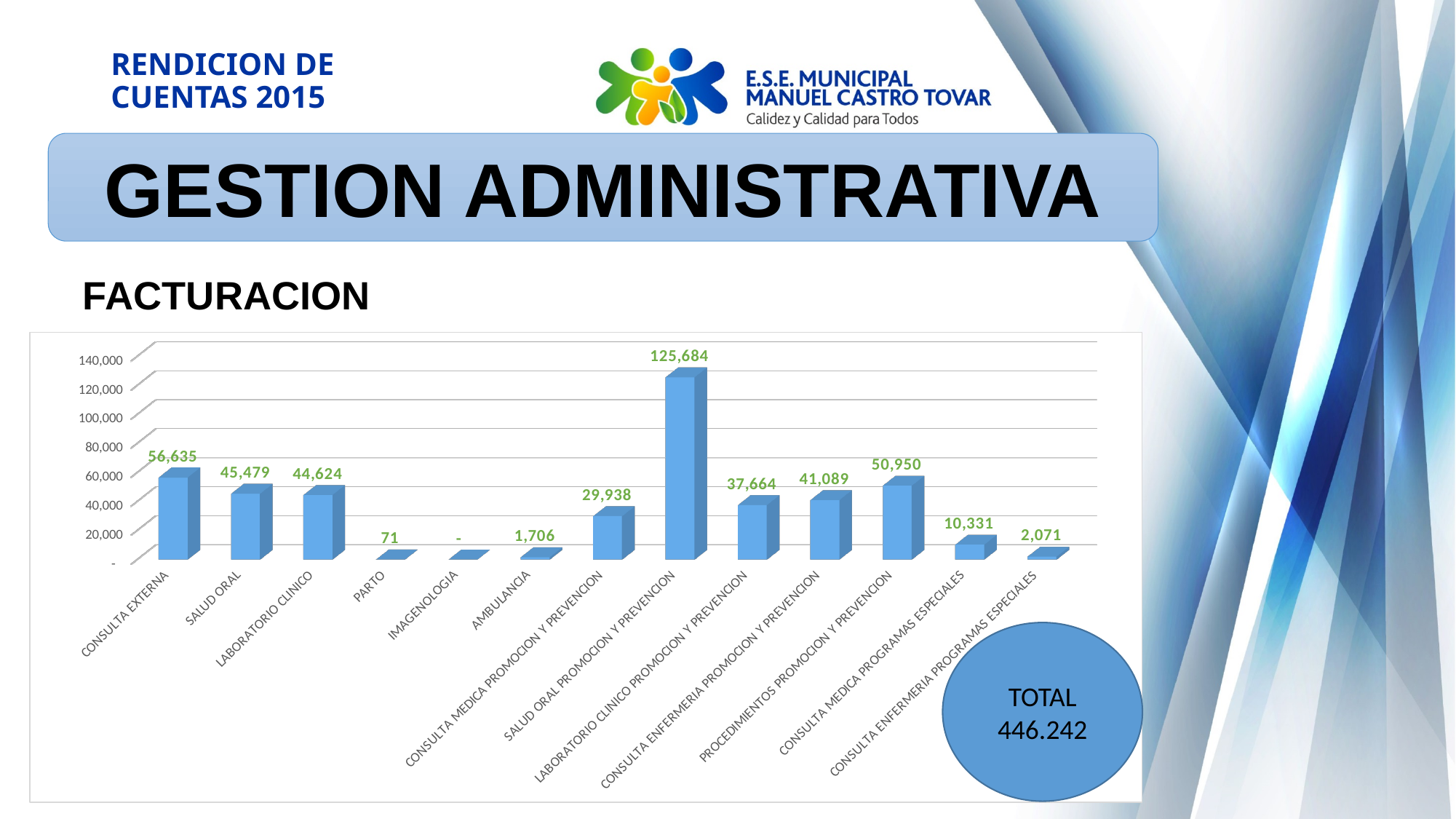
What is the value for SALUD ORAL PROMOCION Y PREVENCION? 125,684 Is the value for PROCEDIMIENTOS PROMOCION Y PREVENCION greater or less than 40,000? greater Which is larger, CONSULTA ENFERMERIA PROMOCION Y PREVENCION or LABORATORIO CLINICO PROMOCION Y PREVENCION? CONSULTA ENFERMERIA PROMOCION Y PREVENCION What is the difference between CONSULTA EXTERNA and SALUD ORAL? 11,156 What is the value for AMBULANCIA? 1,706 How many categories are shown in the chart? 13 What kind of chart is shown on the slide? bar chart Which category has the highest value? SALUD ORAL PROMOCION Y PREVENCION Which category has the lowest value? IMAGENOLOGIA What is the value for CONSULTA EXTERNA? 56,635 What is the difference between SALUD ORAL PROMOCION Y PREVENCION and PROCEDIMIENTOS PROMOCION Y PREVENCION? 74,734 What is the value for CONSULTA MEDICA PROGRAMAS ESPECIALES? 10,331